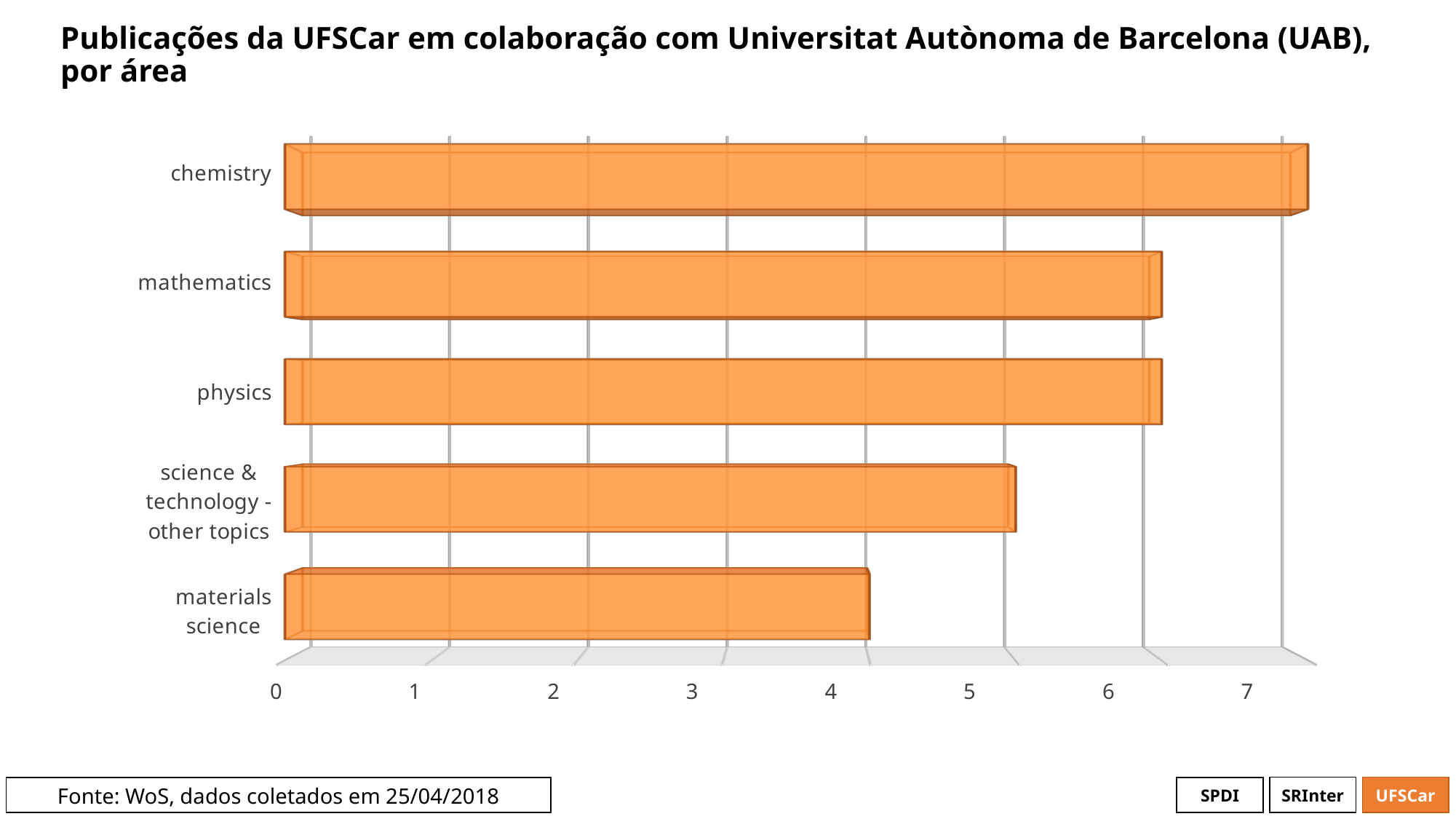
Which area has the lowest number of publications? materials science Is the value for science & technology - other topics greater or less than 6? less What kind of chart is shown on the slide? bar chart Which is larger, the value for chemistry or the value for mathematics? chemistry How many areas (categories) are shown in the chart? 5 Which area has the highest number of publications? chemistry Which is larger, the value for science & technology - other topics or the value for materials science? science & technology - other topics Is the value for physics greater or less than 5? greater Is the value for mathematics greater or less than 5? greater What is the title of the chart? Publicações da UFSCar em colaboração com Universitat Autònoma de Barcelona (UAB), por área